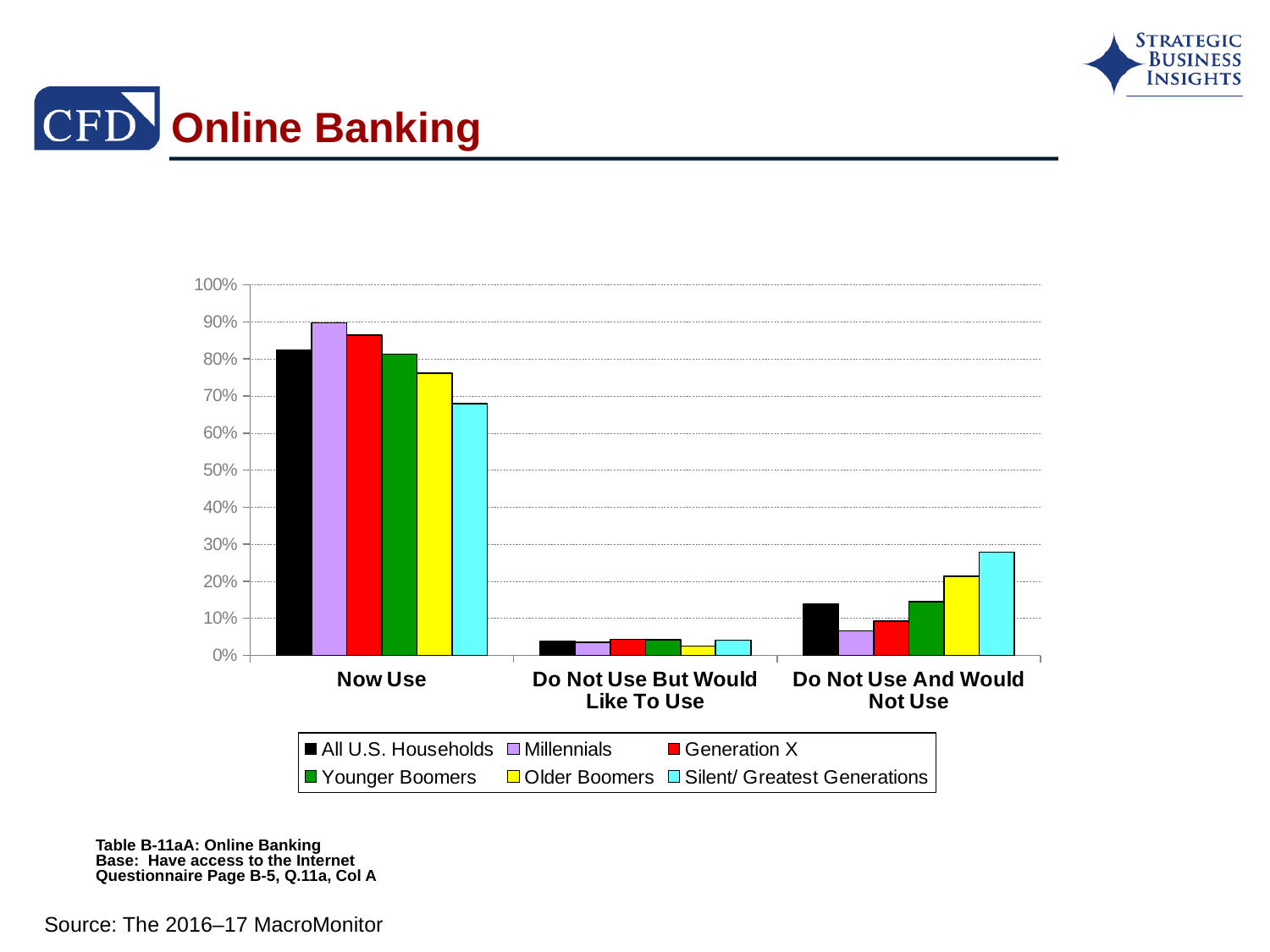
Is the value for Silent/ Greatest Generations in the Now Use category greater or less than 60%? greater In the Now Use category, which is larger: Generation X or Younger Boomers? Generation X In the Do Not Use And Would Not Use category, which series has the highest value? Silent/ Greatest Generations Is the value for Millennials in the Now Use category greater or less than 80%? greater In the Do Not Use And Would Not Use category, which series has the lowest value? Millennials How many series does the legend list? 6 What colour represents Generation X in the legend? red In the Now Use category, which series has the highest value? Millennials How many categories are shown on the x axis? 3 In the Now Use category, which series has the lowest value? Silent/ Greatest Generations What kind of chart is shown on the slide? bar chart Is the value for Silent/ Greatest Generations in the Do Not Use And Would Not Use category greater or less than 20%? greater